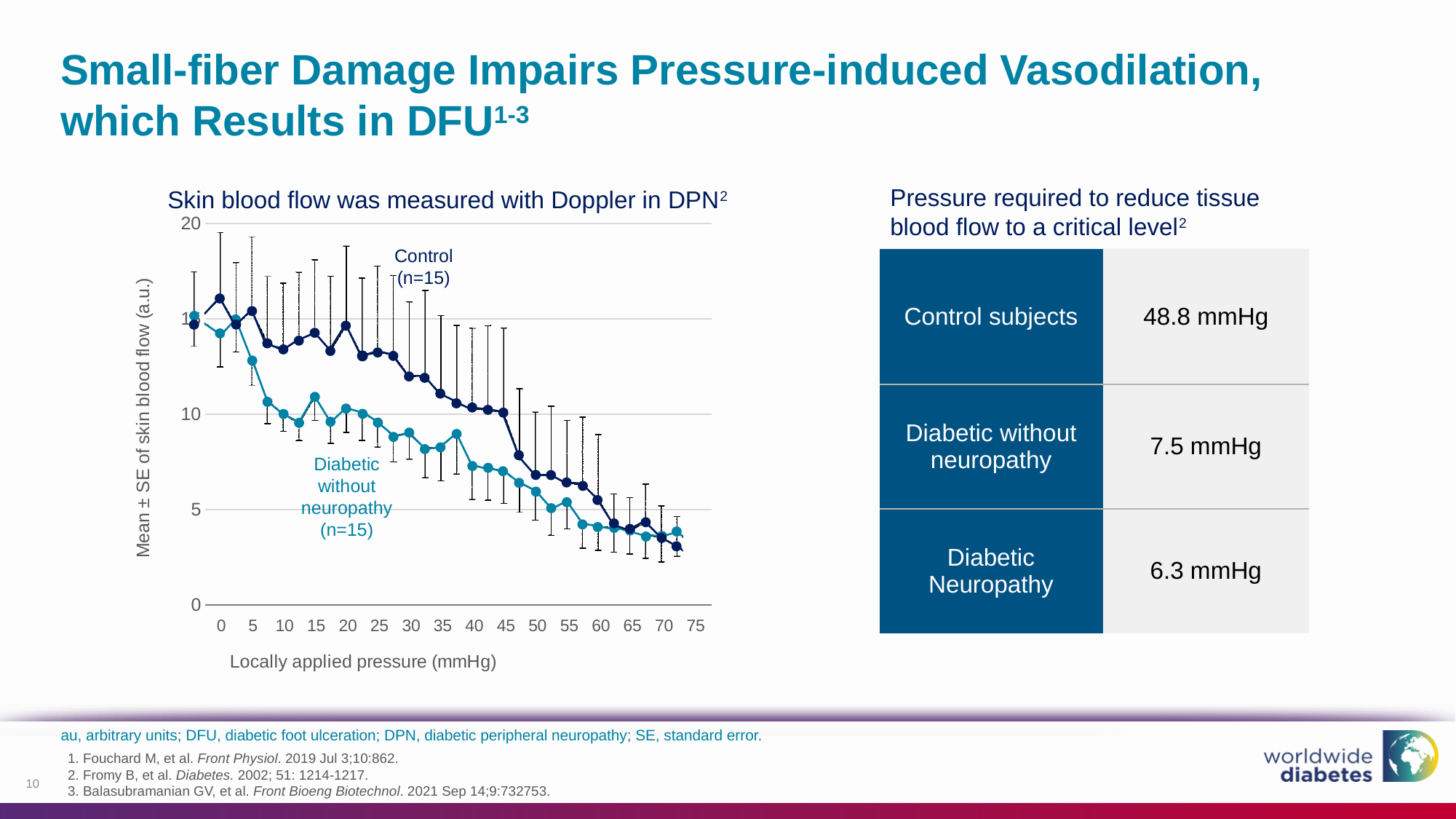
In the skin blood flow chart, which series has the higher value at 30 mmHg, Control or Diabetic without neuropathy? Control What is the x-axis title of the skin blood flow chart? Locally applied pressure (mmHg) What is the sample size (n) given for the Control series in the skin blood flow chart? n=15 In the skin blood flow chart, is the Diabetic without neuropathy value at 20 mmHg greater or less than 15? less In the skin blood flow chart, do the values generally rise or fall as locally applied pressure increases? Fall In the skin blood flow chart, is the Control value at 70 mmHg greater or less than 5? less In the skin blood flow chart, is the Diabetic without neuropathy value at 60 mmHg greater or less than 5? less What kind of chart is shown on the slide? Line chart In the skin blood flow chart, which series has the higher value at 45 mmHg, Control or Diabetic without neuropathy? Control How many data series are plotted in the skin blood flow chart? 2